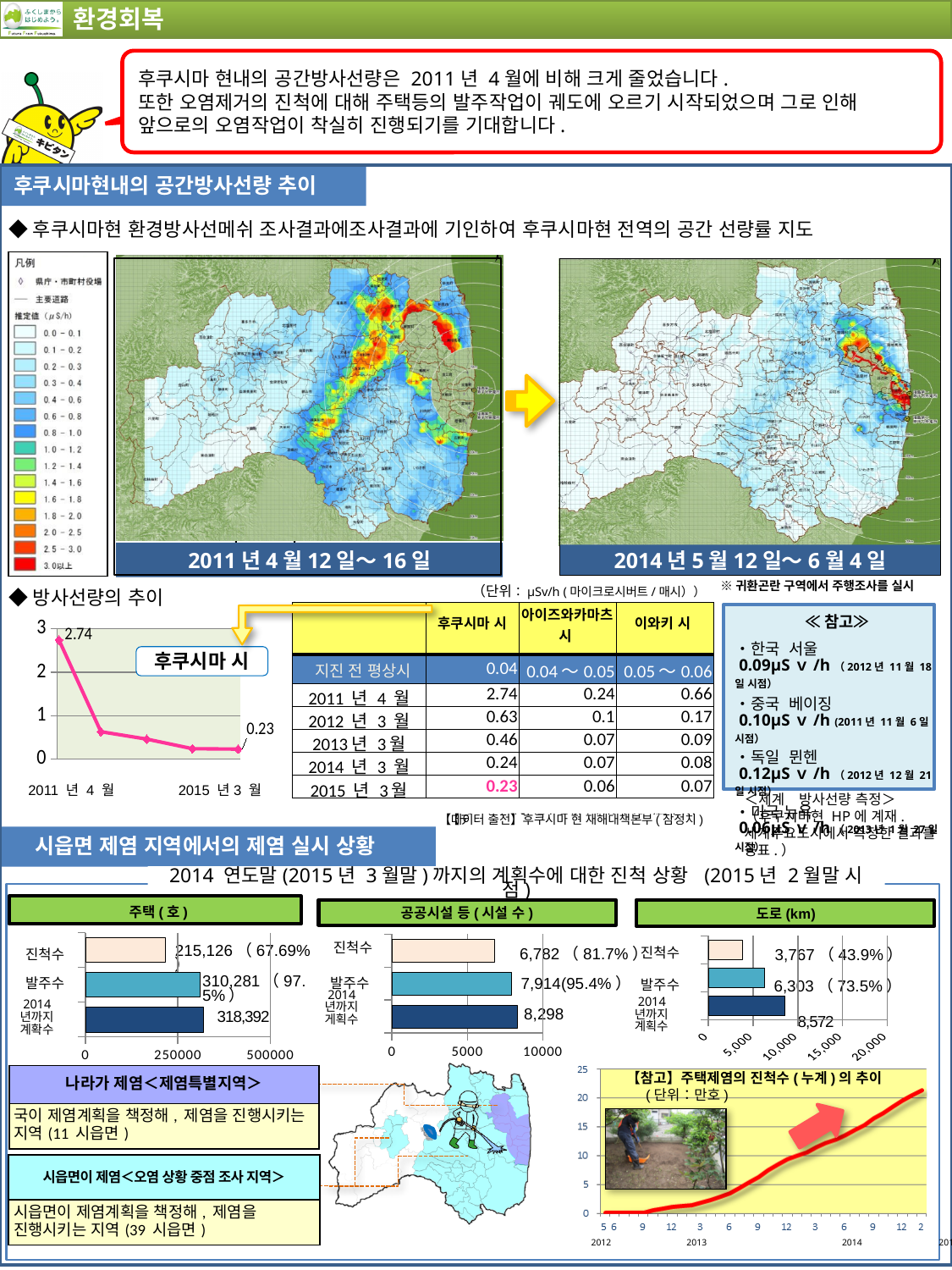
In the '도로 (km)' chart, what is the difference between 발주수 and 진척수? 2,536 In the '도로 (km)' chart, which category has the lowest value? 진척수 What kind of chart is the '공공시설 등 (시설 수)' chart? bar chart In the '방사선량의 추이' line chart for 후쿠시마 시, do the values rise or fall from 2011년 4월 to 2015년 3월? fall In the '공공시설 등 (시설 수)' chart, what is the value for 발주수? 7,914 In the '【참고】 주택제염의 진척수 (누계) 의 추이' chart, is the final value greater or less than 20? greater In the '방사선량의 추이' line chart for 후쿠시마 시, what is the value plotted for 2015년 3월? 0.23 In the '주택 (호)' chart, what is the value for 진척수? 215,126 In the '주택 (호)' chart, what is the value for 2014년까지 계획수? 318,392 In the '주택 (호)' chart, what is the difference between 2014년까지 계획수 and 발주수? 8,111 What kind of chart is the '방사선량의 추이' chart for 후쿠시마 시? line chart In the '방사선량의 추이' line chart for 후쿠시마 시, what is the value plotted for 2011년 4월? 2.74